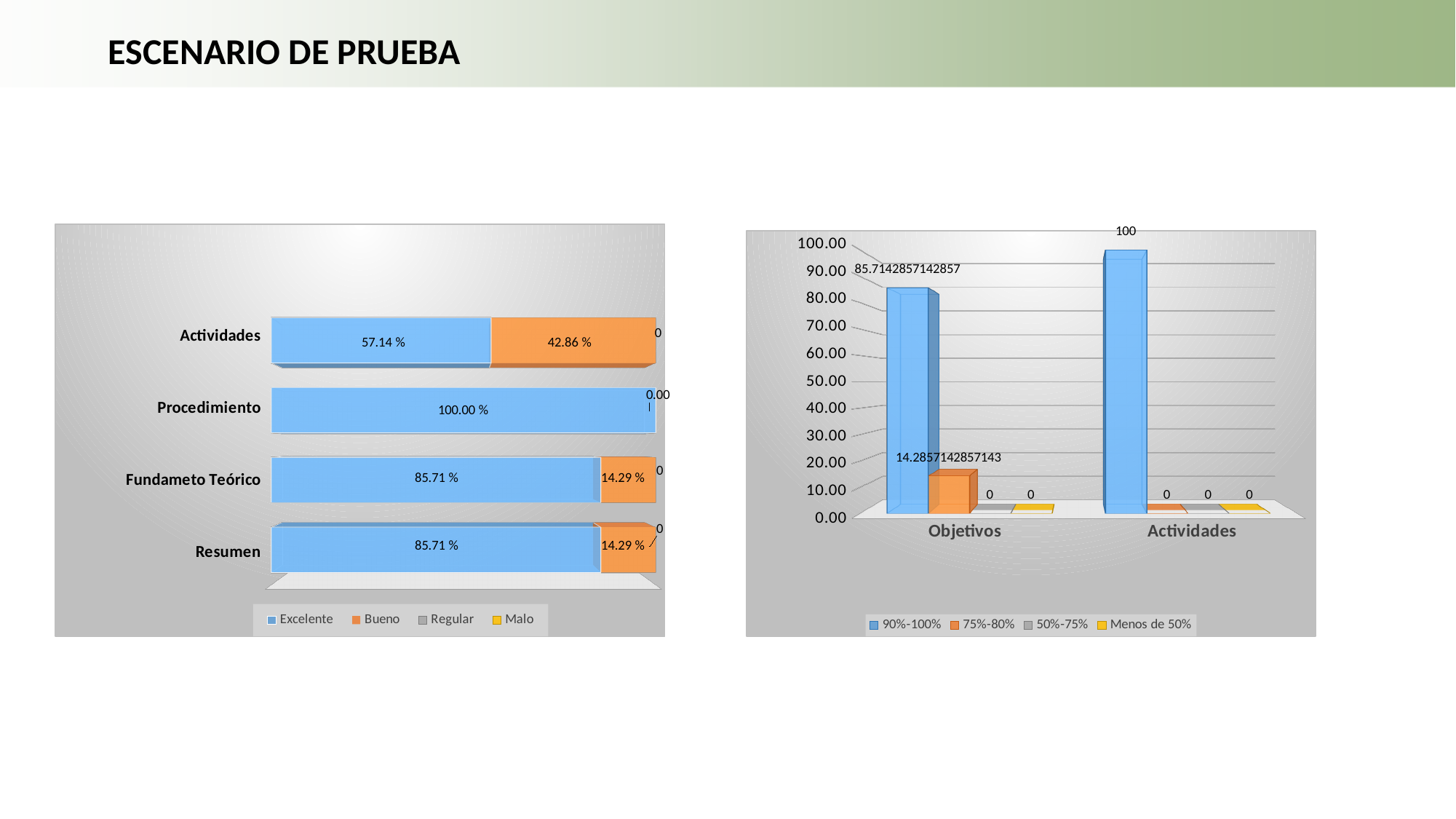
In the left chart, which category has the lowest Excelente value? Actividades In the left chart, which category has the highest Excelente value? Procedimiento In the right chart, what is the 75%-80% value for Objetivos? 14.2857142857143 In the right chart, what is the 90%-100% value for Actividades? 100 In the left chart, what is the Bueno value for Actividades? 42.86 % In the right chart, how many categories are shown on the x axis? 2 In the left chart, how many series does the legend list? 4 In the right chart, what is the 90%-100% value for Objetivos? 85.7142857142857 In the left chart, what is the difference between the Excelente and Bueno values for Actividades? 14.28 % In the left chart, what is the Excelente value for Actividades? 57.14 % In the left chart, what is the Excelente value for Procedimiento? 100.00 % In the left chart, what is the Bueno value for Fundameto Teórico? 14.29 %